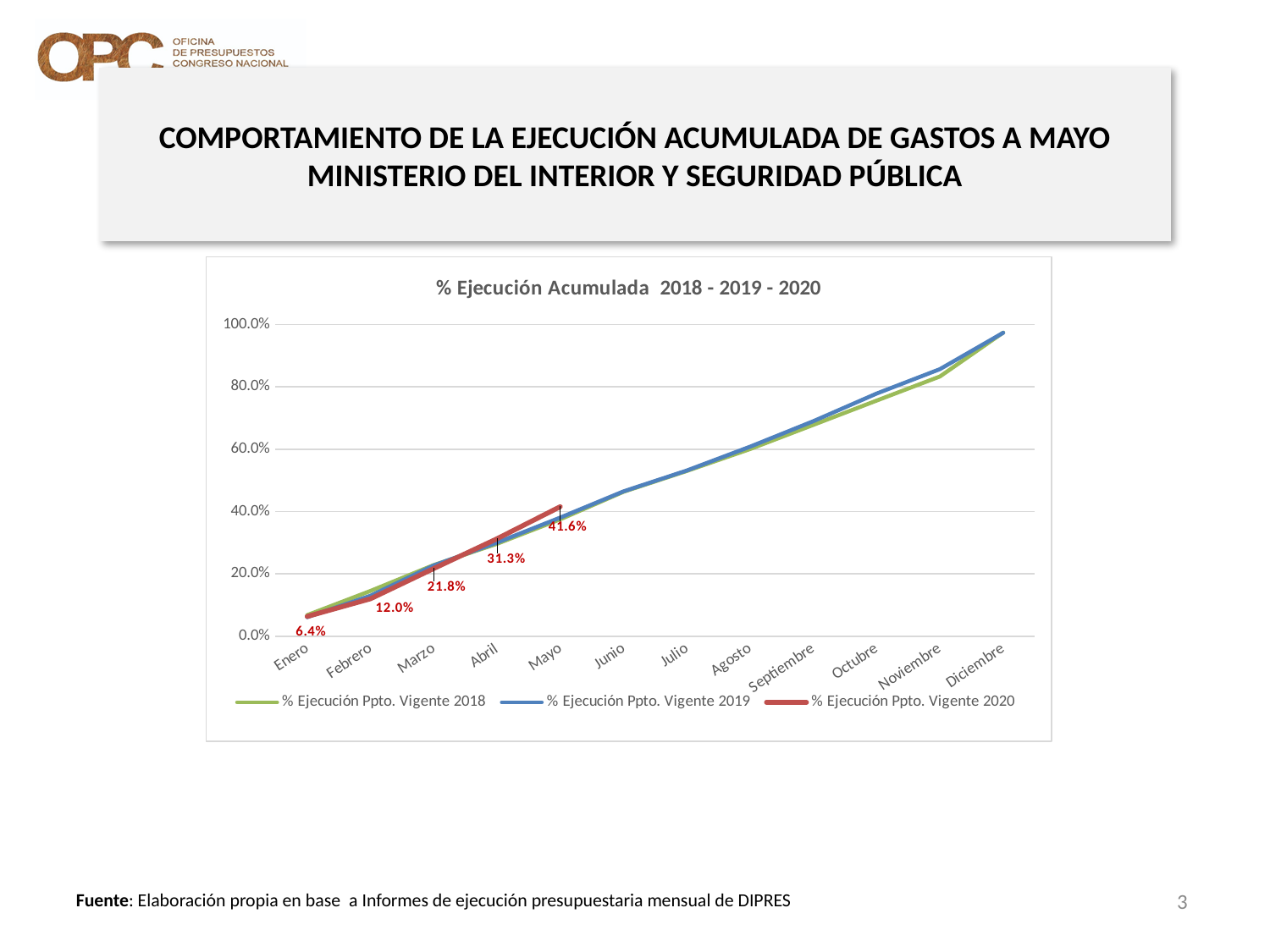
What is the title of the chart? % Ejecución Acumulada 2018 - 2019 - 2020 What kind of chart is shown on the slide? Line chart Is the value for Diciembre in the % Ejecución Ppto. Vigente 2019 series greater or less than 80%? greater What is the value for Enero in the % Ejecución Ppto. Vigente 2020 series? 6.4% What is the value for Abril in the % Ejecución Ppto. Vigente 2020 series? 31.3% Do the values of the % Ejecución Ppto. Vigente 2019 series rise or fall from Enero to Diciembre? Rise Which month has the highest value in the % Ejecución Ppto. Vigente 2020 series? Mayo What is the value for Mayo in the % Ejecución Ppto. Vigente 2020 series? 41.6% How many months are shown on the x axis? 12 How many series does the legend list? 3 What is the value for Marzo in the % Ejecución Ppto. Vigente 2020 series? 21.8% What is the difference between the Mayo and Abril values in the % Ejecución Ppto. Vigente 2020 series? 10.3 percentage points